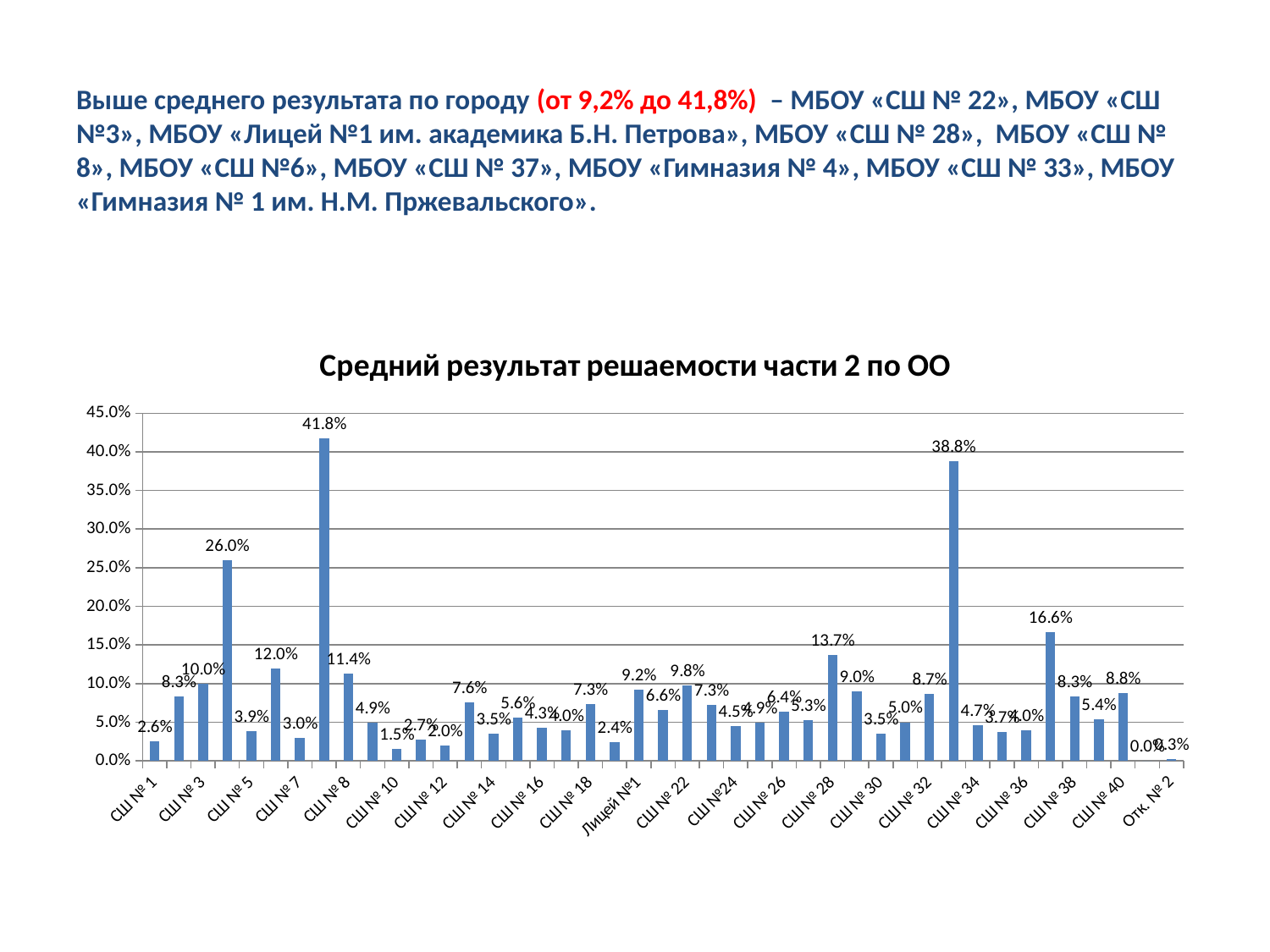
What kind of chart is shown on the slide? bar chart What is the value for СШ № 1? 2.6% What is the lowest value shown in the chart? 0.0% Which has a larger value, СШ № 28 or СШ № 22? СШ № 28 What is the value for Отк. № 2? 0.3% What is the value for СШ № 34? 4.7% What is the value for СШ № 38? 8.3% What is the highest value shown in the chart? 41.8% Is the value for СШ № 34 greater or less than 35.0%? less What is the value for Лицей №1? 9.2% What is the difference between the values for СШ № 34 and СШ № 38? 3.6% What is the title of the chart? Средний результат решаемости части 2 по ОО